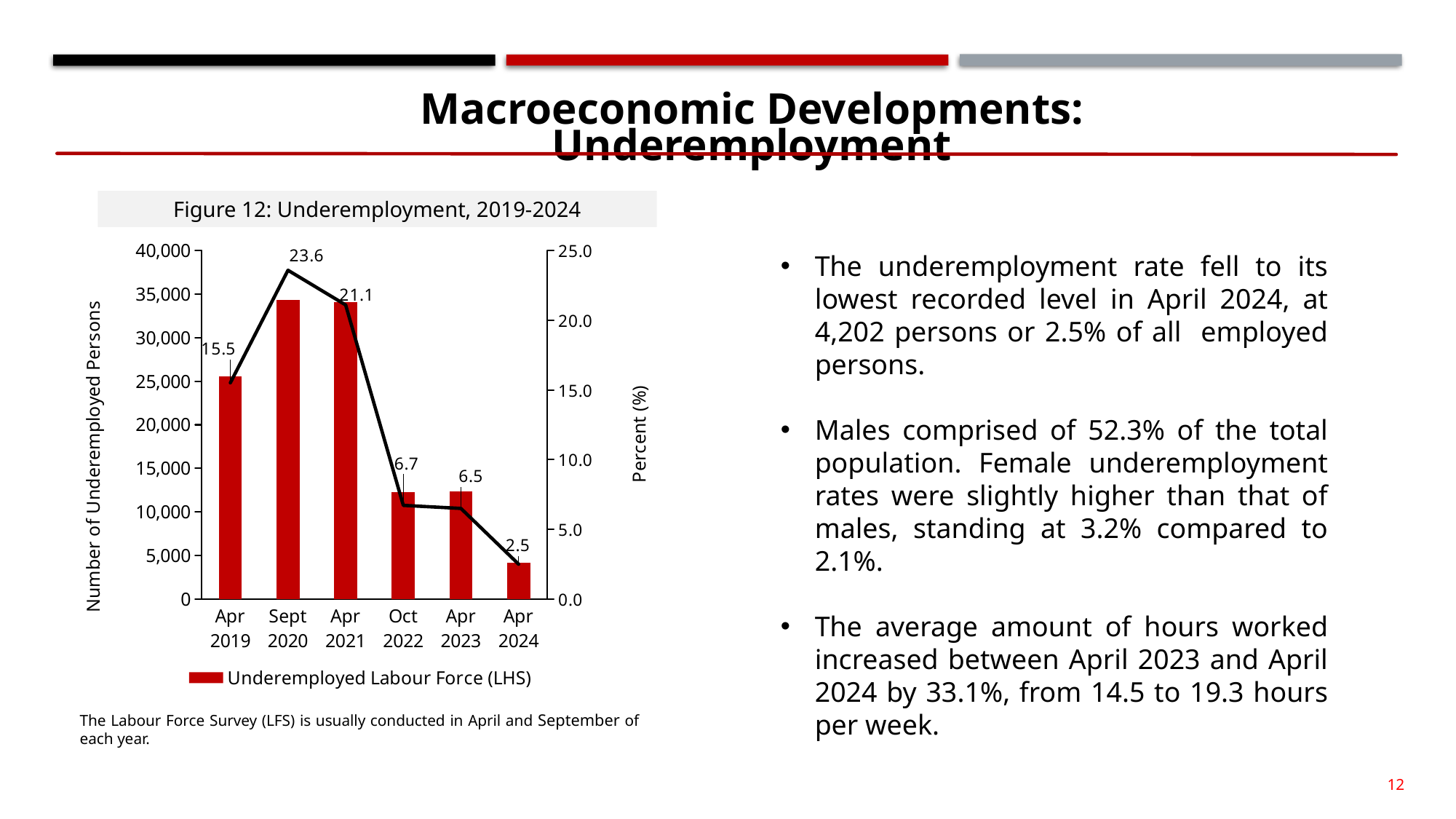
Is the number of underemployed persons for Apr 2024 in Figure 12 greater or less than 5,000? less In which period is the underemployment rate (percent line) lowest in Figure 12? Apr 2024 What is the underemployment rate (percent) shown for Apr 2019 in Figure 12? 15.5 How many time periods are shown on the x axis of Figure 12? 6 Is the number of underemployed persons for Apr 2019 in Figure 12 greater or less than 20,000? greater Which period has a higher underemployment rate in Figure 12, Oct 2022 or Apr 2023? Oct 2022 Does the underemployment rate (percent line) in Figure 12 rise or fall from Sept 2020 to Apr 2024? fall What is the underemployment rate (percent) shown for Sept 2020 in Figure 12? 23.6 How many series does the legend of Figure 12 list? 1 In which period is the underemployment rate (percent line) highest in Figure 12? Sept 2020 By how many percentage points does the underemployment rate in Sept 2020 exceed that in Apr 2021 in Figure 12? 2.5 What is the underemployment rate (percent) shown for Apr 2024 in Figure 12? 2.5